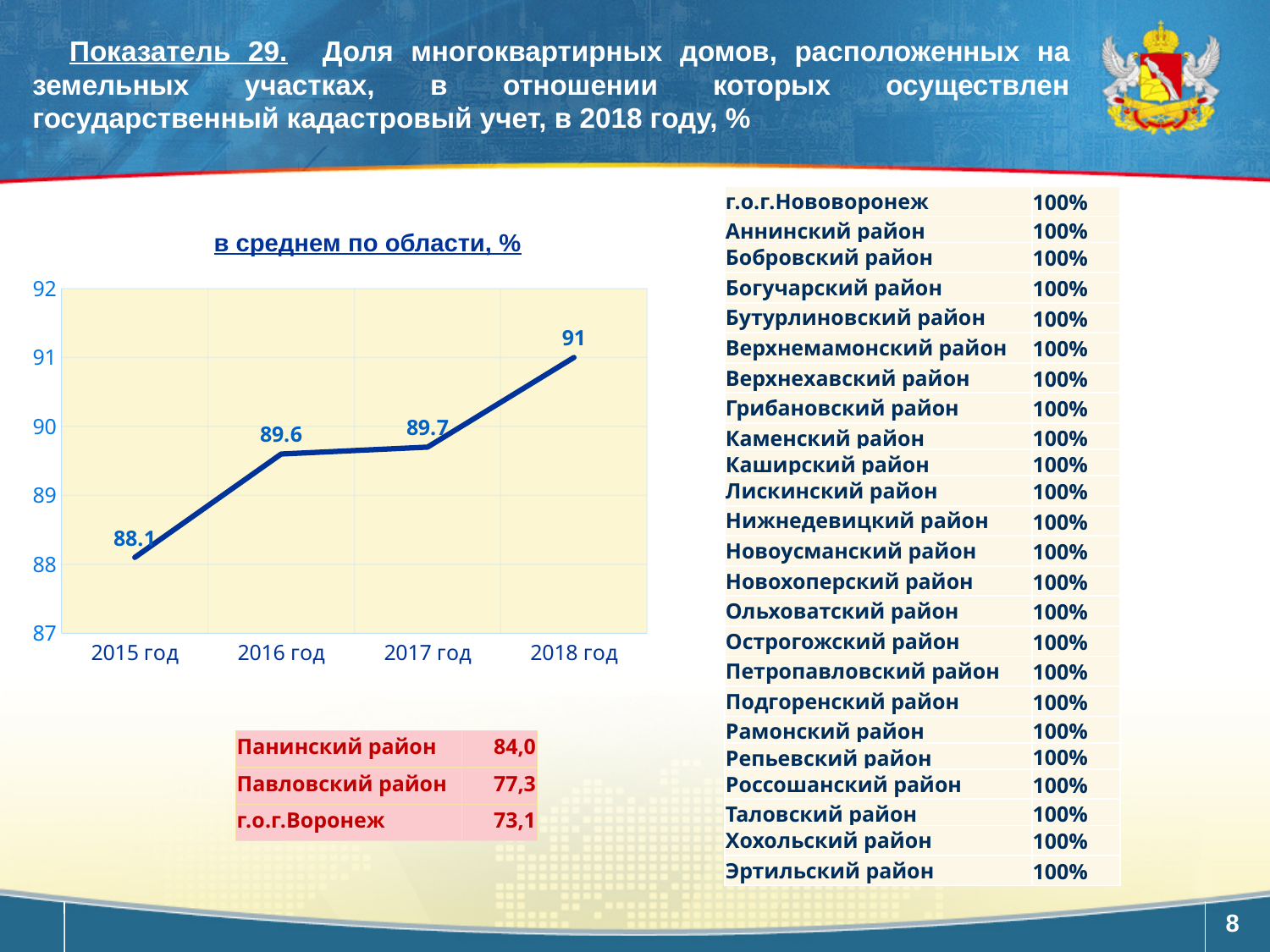
Which year has the highest value? 2018 год What is the value for 2015 год? 88.1 Do the values rise or fall from 2015 год to 2018 год? rise What is the difference between the values for 2018 год and 2015 год? 2.9 Which year has the lowest value? 2015 год Is the value for 2015 год greater or less than 89? less What is the value for 2018 год? 91 What is the value for 2017 год? 89.7 What is the value for 2016 год? 89.6 Which is larger, the value for 2016 год or the value for 2018 год? 2018 год How many data points are plotted on the chart? 4 What type of chart is shown on the slide? line chart